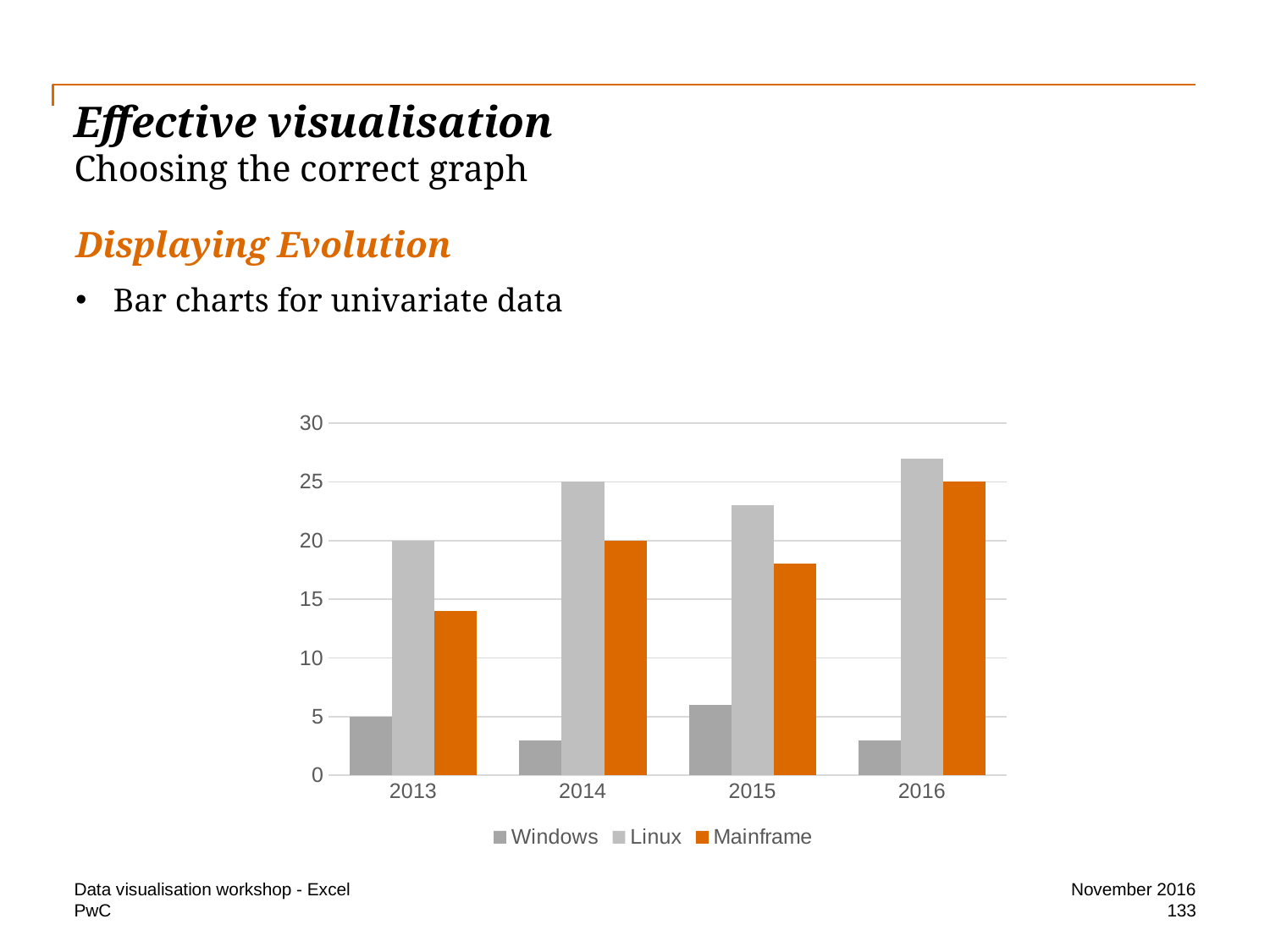
What kind of chart is shown on the slide? bar chart In which year is the Linux value highest? 2016 How many years are shown on the x axis? 4 Which series is shown in orange in the legend? Mainframe Is the value for Linux in 2016 greater or less than 25? greater What is the value for Windows in 2013? 5 What is the value for Mainframe in 2016? 25 Is the value for Mainframe in 2013 greater or less than 15? less Which is larger in 2015, Linux or Mainframe? Linux What is the value for Linux in 2014? 25 What is the difference between Linux and Windows in 2013? 15 How many series does the legend list? 3